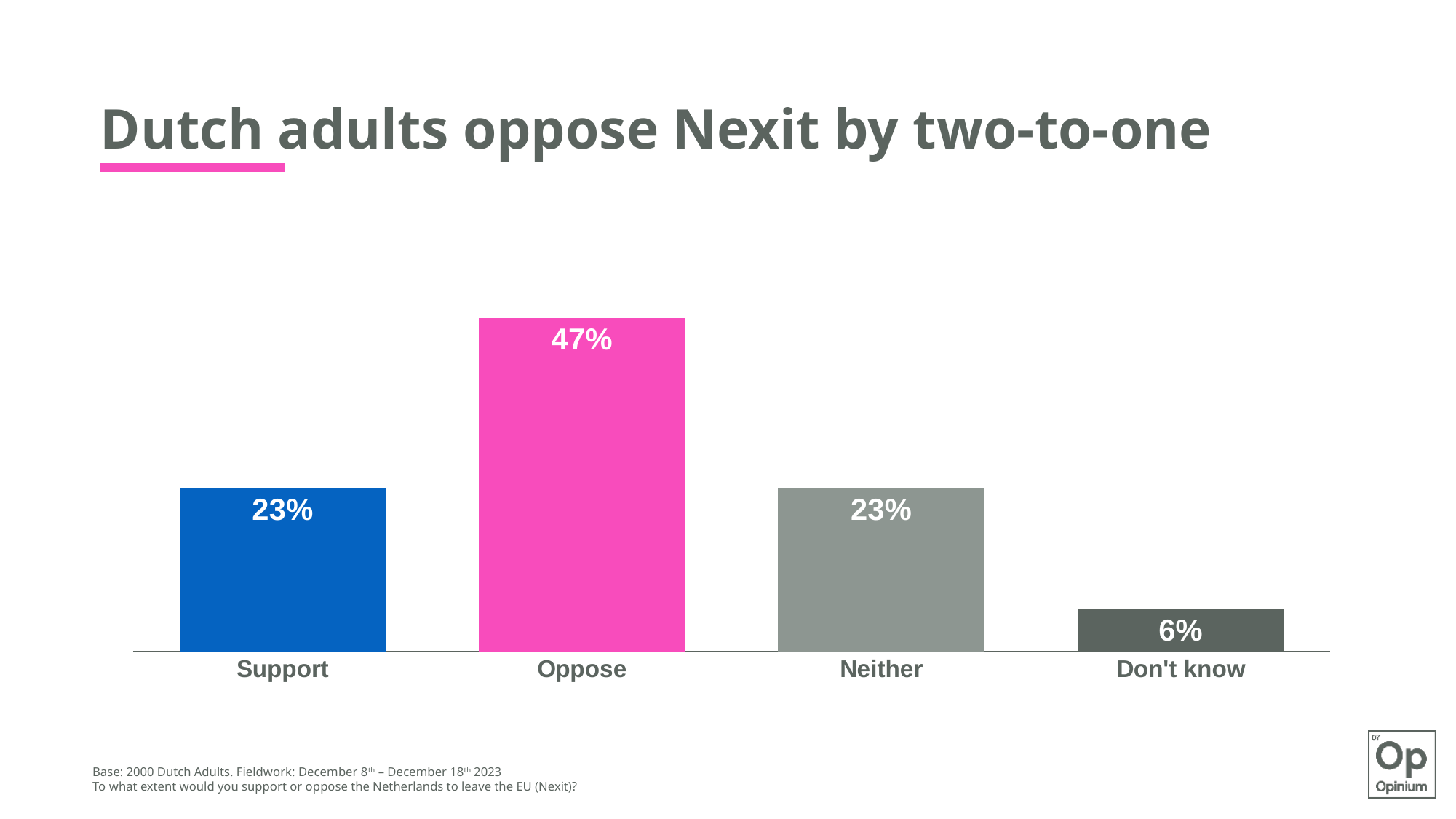
What is the difference in percentage points between Oppose and Support? 24 percentage points What colour is the Oppose bar? Pink How many categories are shown in the chart? 4 What is the value for the Neither category? 23% What percentage of Dutch adults oppose Nexit? 47% What percentage of Dutch adults support Nexit? 23% Which category has the highest value? Oppose What kind of chart is shown on the slide? Bar chart What is the difference between the Neither and Don't know values? 17 percentage points What is the value for the Don't know category? 6% Which category has the lowest value? Don't know Which is larger, the value for Oppose or the value for Neither? Oppose